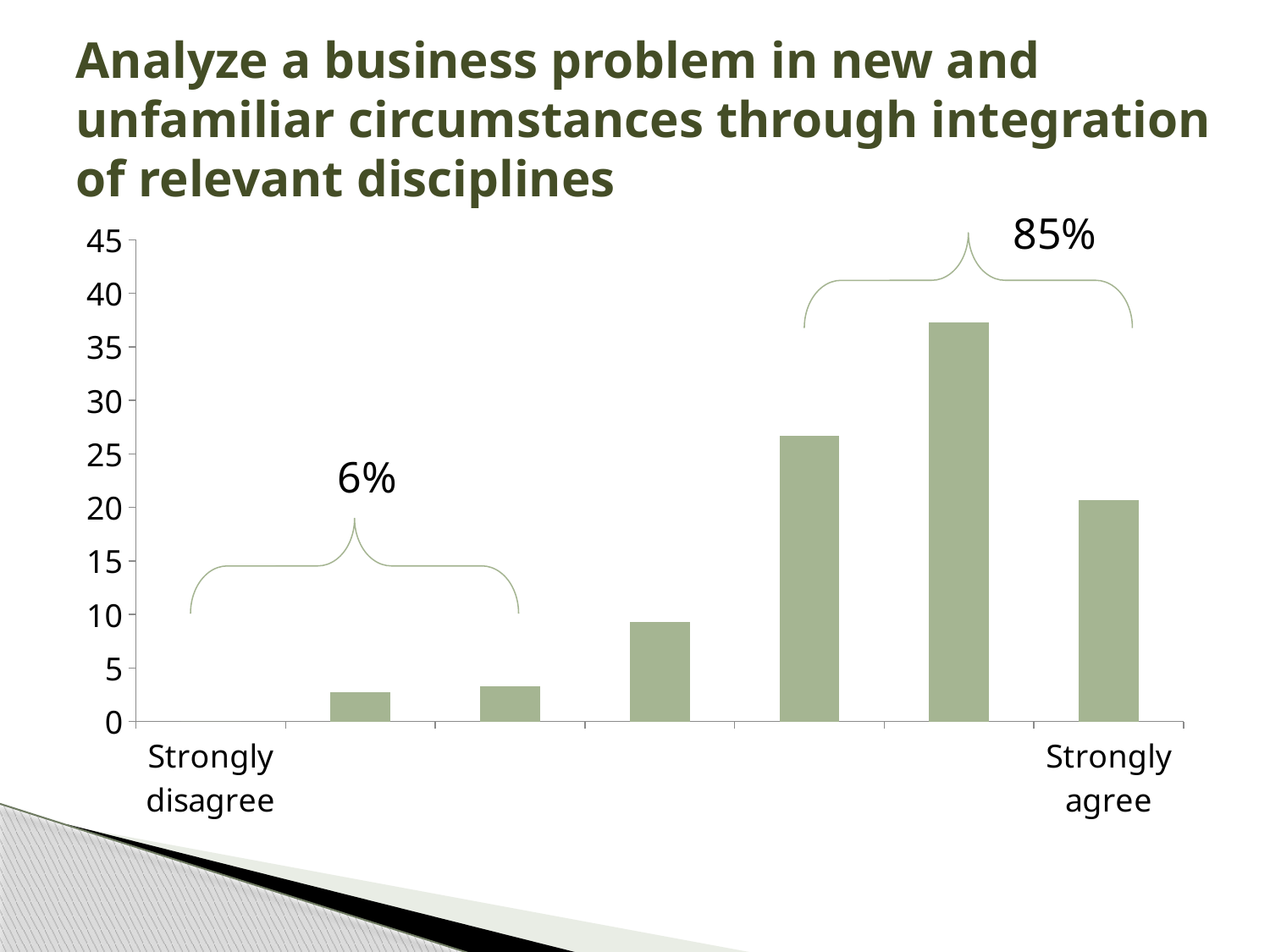
Is the value for Strongly agree greater or less than 25? less Is the tallest bar in the chart greater or less than 35? greater How many bars are visible in the chart? 6 What is the label at the right end of the x axis? Strongly agree What is the highest value shown on the y axis? 45 What percentage is shown above the bracket spanning the three tallest bars on the right? 85% Is the tallest bar the one labelled Strongly agree? No What is the label at the left end of the x axis? Strongly disagree Is the value for Strongly agree greater or less than 15? greater What kind of chart is shown on the slide? bar chart What percentage is shown above the bracket spanning the two short bars on the left? 6% Which is larger, the value for Strongly agree or the value for Strongly disagree? Strongly agree